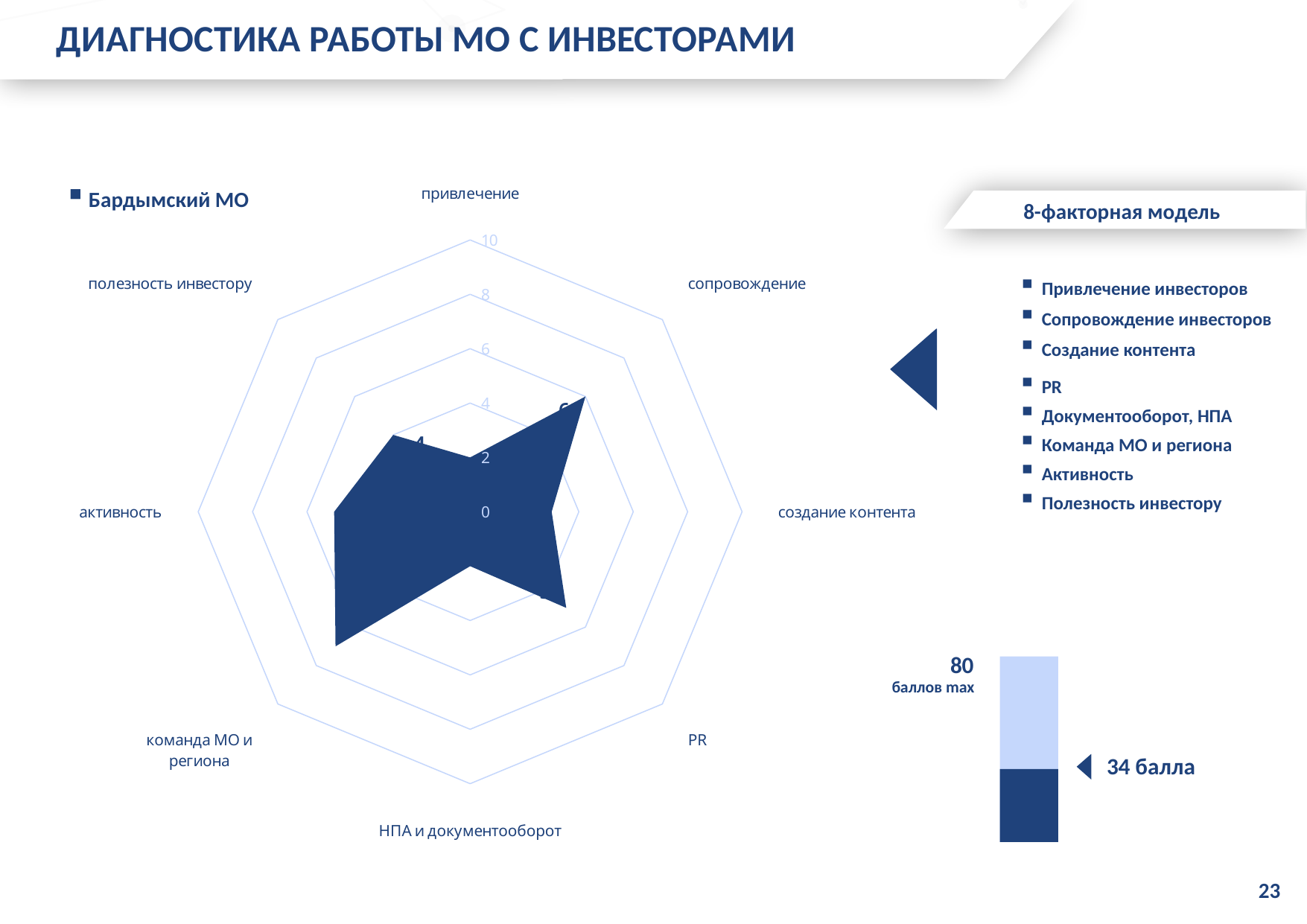
In the radar chart, is the value for команда МО и региона greater or less than 4? greater In the radar chart, is the value for сопровождение greater or less than 4? greater In the radar chart, which is larger: the value for команда МО и региона or the value for НПА и документооборот? команда МО и региона In the radar chart, which is larger: the value for сопровождение or the value for привлечение? сопровождение What score is indicated next to the bar on the right of the slide? 34 балла How many categories (axes) does the radar chart have? 8 What is the maximum value shown on the radar chart's axis scale? 10 In the radar chart, is the value for привлечение greater or less than 4? less What kind of chart is shown on the left of the slide? radar chart